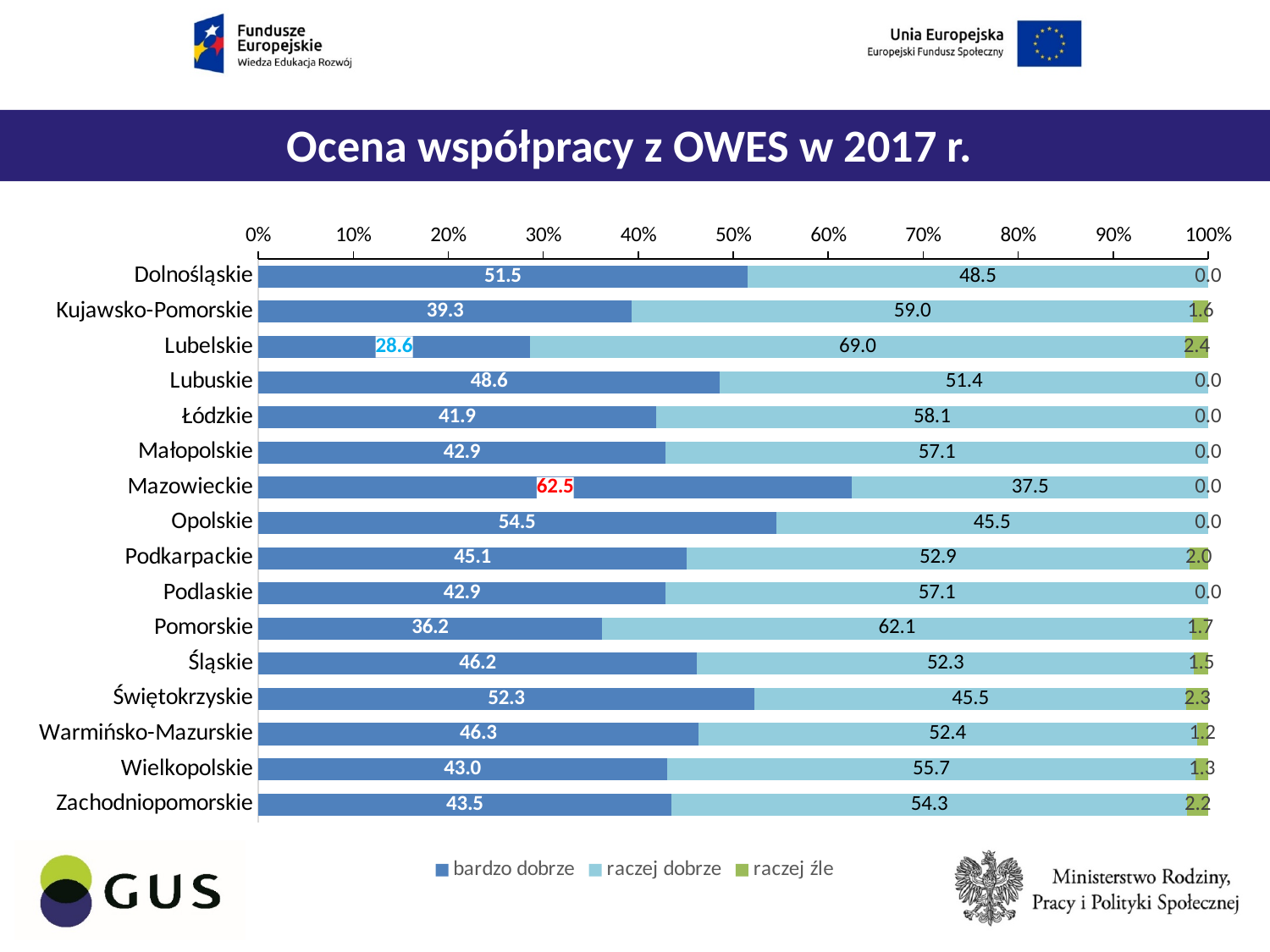
What is the title of the chart? Ocena współpracy z OWES w 2017 r. Which has a larger 'bardzo dobrze' value, Opolskie or Lubuskie? Opolskie What is the 'raczej źle' value for Świętokrzyskie? 2.3 What is the 'bardzo dobrze' value for Mazowieckie? 62.5 How many series does the legend list? 3 What is the difference between the 'bardzo dobrze' and 'raczej dobrze' values for Mazowieckie? 25.0 What is the 'raczej dobrze' value for Lubelskie? 69.0 Which voivodeship has the lowest 'bardzo dobrze' value? Lubelskie What kind of chart is shown on the slide? Stacked bar chart How many voivodeships are shown in the chart? 16 Which voivodeship has the highest 'raczej dobrze' value? Lubelskie Which voivodeship has the highest 'bardzo dobrze' value? Mazowieckie